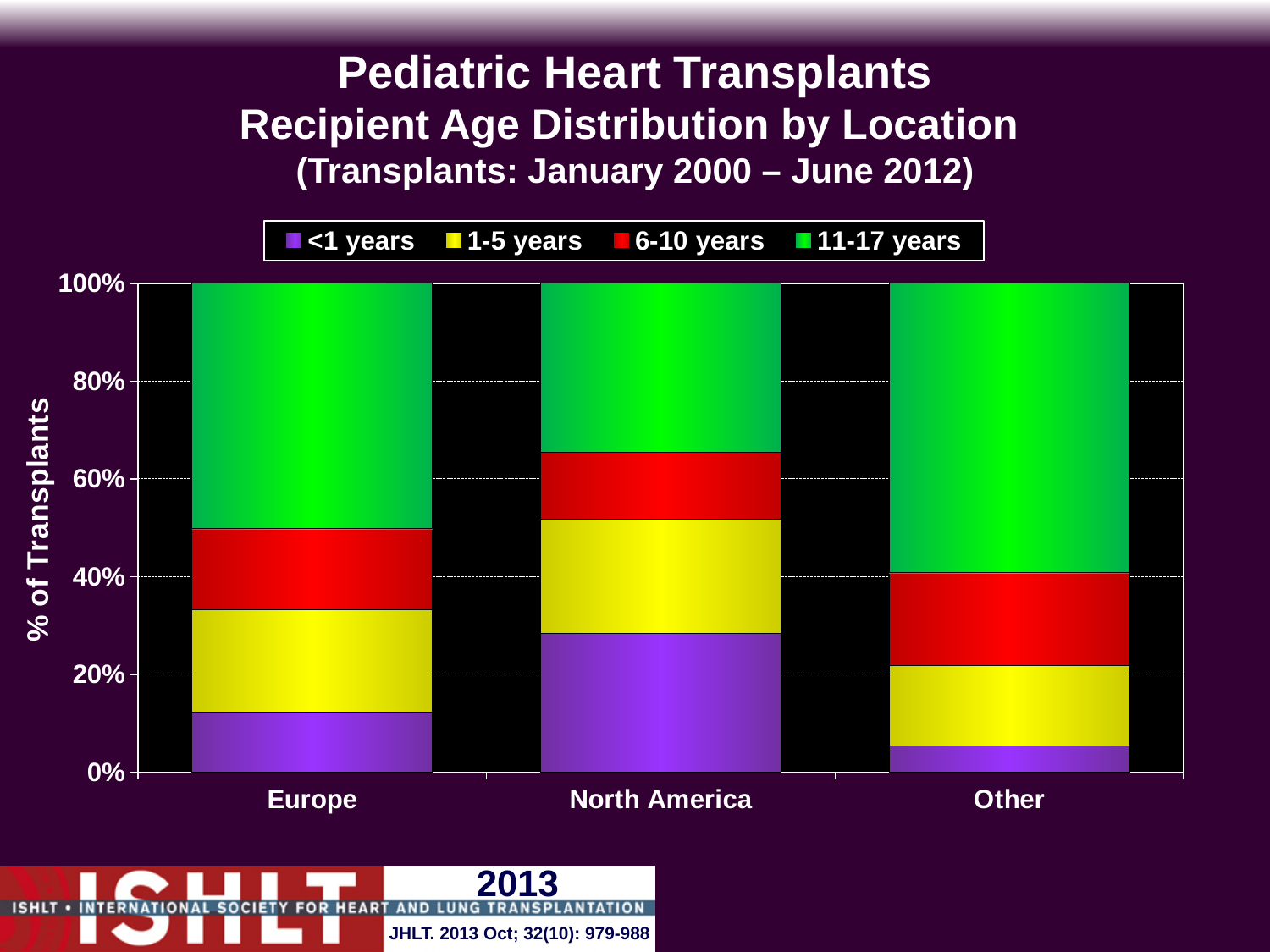
Which location has the smallest share of recipients aged <1 years? Other Which location has the smallest share of recipients aged 11-17 years? North America Which location has the largest share of recipients aged 11-17 years? Other Which has a larger share of 11-17 years recipients, Europe or Other? Other Is the share of 11-17 years recipients in North America greater or less than 40%? less How many age groups does the legend list? 4 How many locations are shown on the x axis of the chart? 3 What is the label on the y axis of the chart? % of Transplants What kind of chart is shown on the slide? Stacked bar chart Is the share of <1 years recipients in North America greater or less than 20%? greater Is the share of <1 years recipients in Europe greater or less than 20%? less Which location has the largest share of recipients aged <1 years? North America